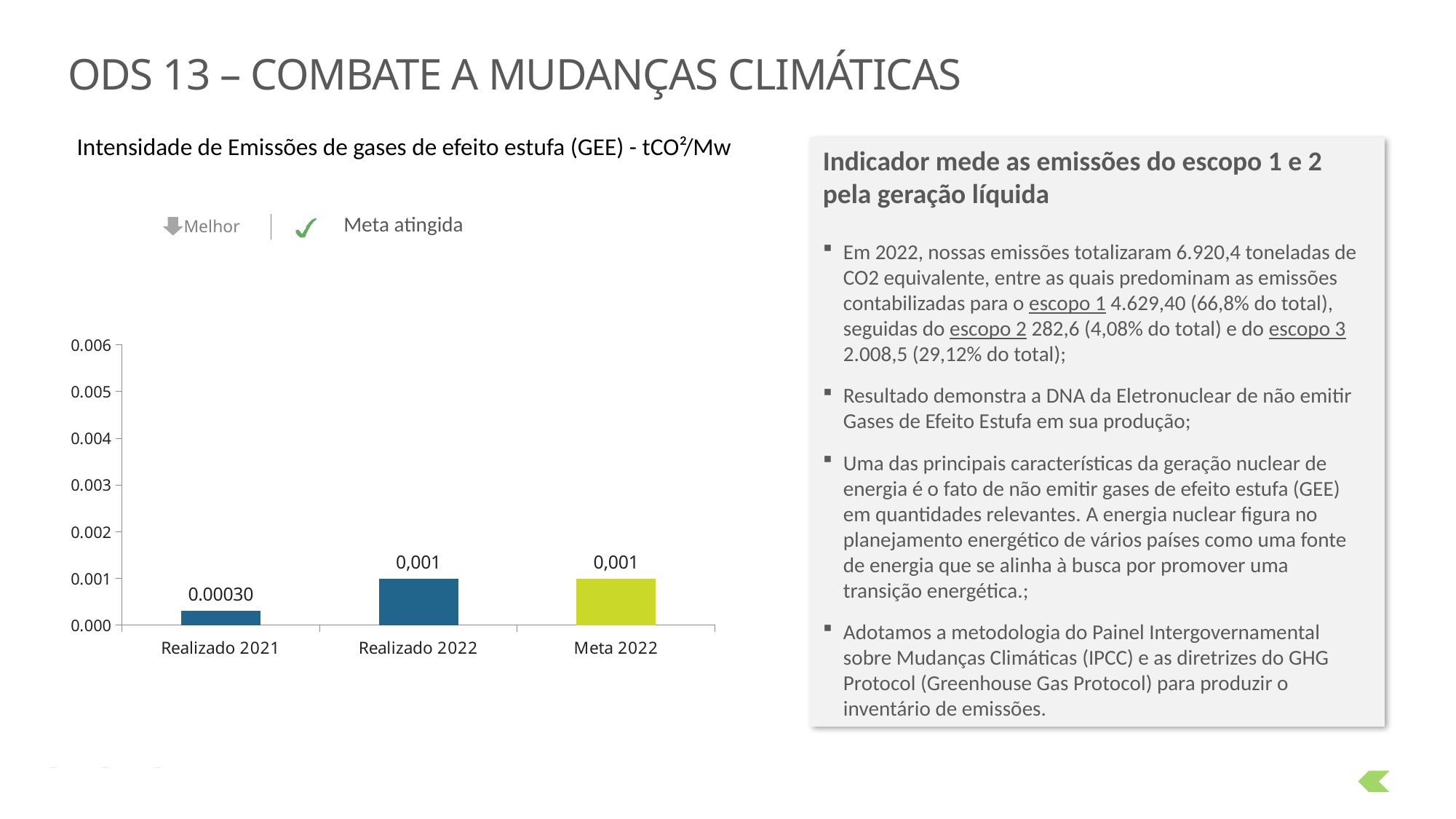
How many categories are shown on the x axis? 3 What is the value for Realizado 2021? 0.00030 What is the value for Meta 2022? 0,001 Is the value for Realizado 2021 greater or less than 0.001? less Which is larger, the value for Realizado 2021 or the value for Realizado 2022? Realizado 2022 Which category has the lowest value? Realizado 2021 What is the value for Realizado 2022? 0,001 What colour is the bar for Meta 2022? yellow-green What is the title of the chart? Intensidade de Emissões de gases de efeito estufa (GEE) - tCO²/Mw What kind of chart is shown on the slide? bar chart Does the value rise or fall from Realizado 2021 to Realizado 2022? rise Is the value for Meta 2022 greater or less than 0.002? less